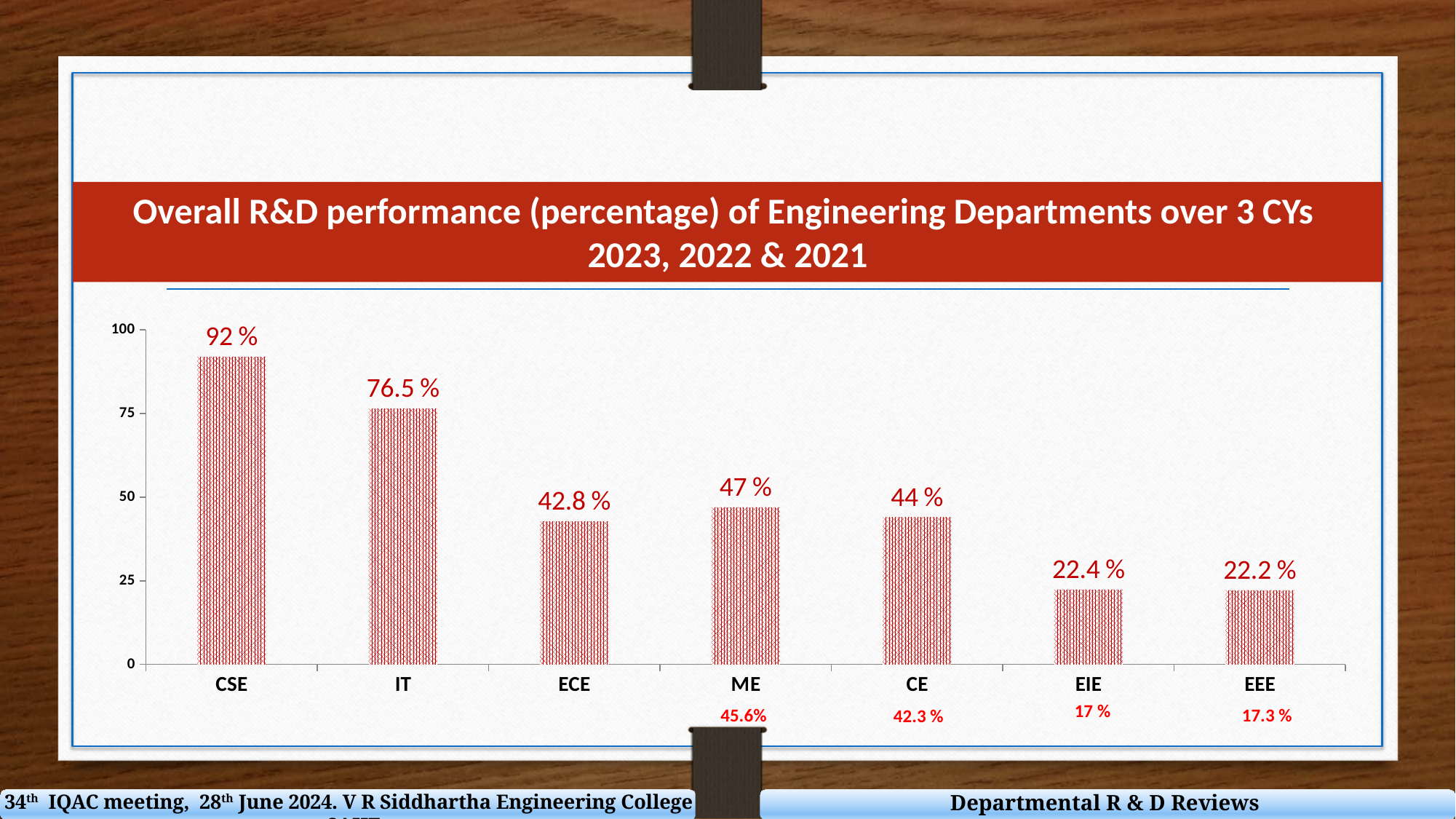
What is the value for EIE? 22.4 % Which department has the highest value? CSE What kind of chart is shown on the slide? bar chart Is the value for IT greater or less than 75? greater How many departments are shown on the x axis? 7 What is the value for ECE? 42.8 % What is the difference between the values for CSE and IT? 15.5 % What is the difference between the values for ME and CE? 3 % Which department has the lowest value? EEE What is the value for CSE? 92 % Which is larger, the value for ME or the value for ECE? ME What is the value for IT? 76.5 %